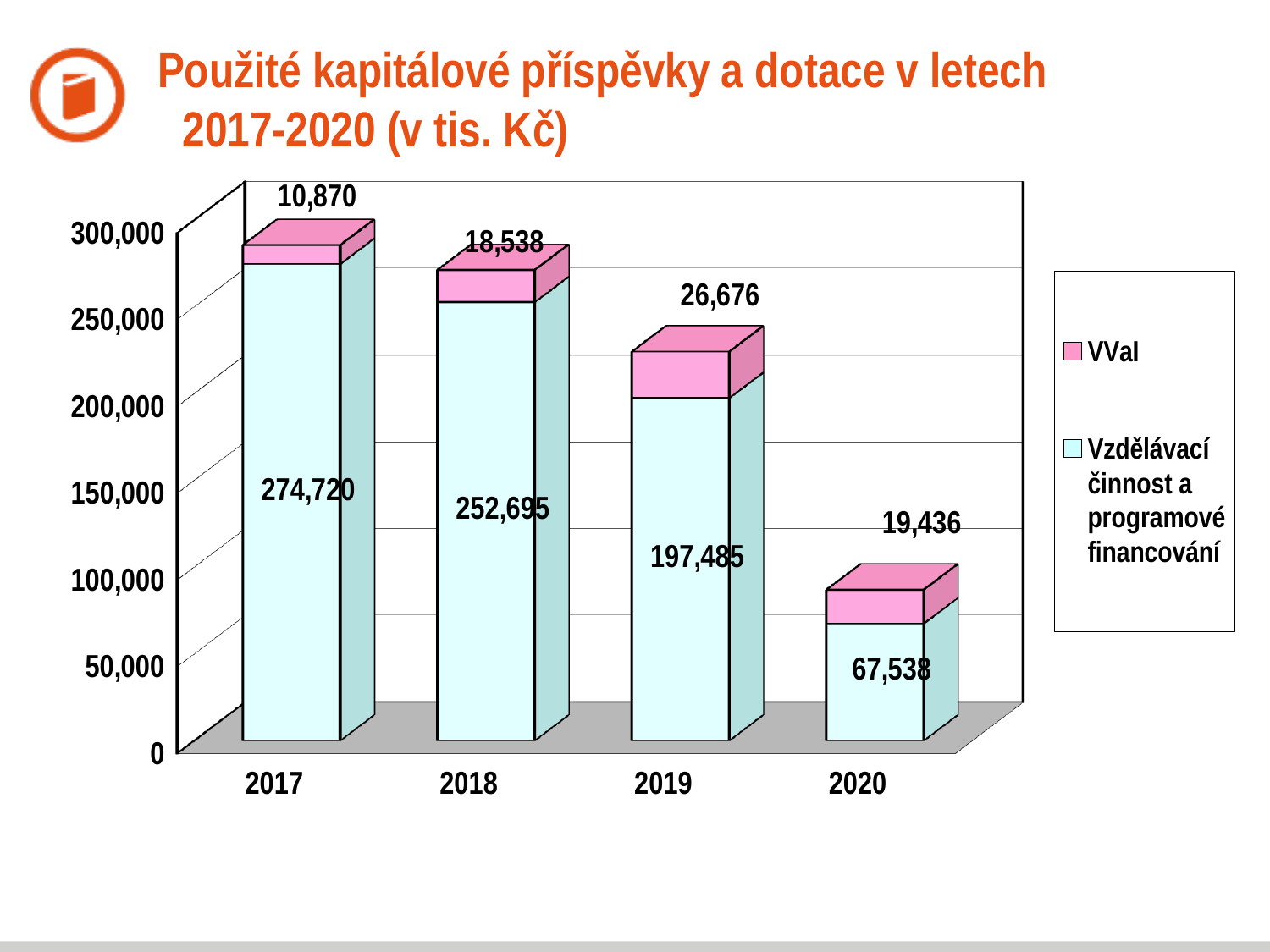
What is the total of the stacked bar for 2019? 224,161 What is the VVaI value for 2018? 18,538 Which year has the lowest value for Vzdělávací činnost a programové financování? 2020 What is the value for Vzdělávací činnost a programové financování in 2020? 67,538 What is the value for Vzdělávací činnost a programové financování in 2017? 274,720 What is the difference between the Vzdělávací činnost a programové financování values for 2017 and 2018? 22,025 What is the VVaI value for 2019? 26,676 What kind of chart is shown on the slide? Stacked bar chart Which year has the highest VVaI value? 2019 Which is larger, the VVaI value for 2020 or for 2017? 2020 How many series does the legend list? 2 How many years are shown on the x axis? 4